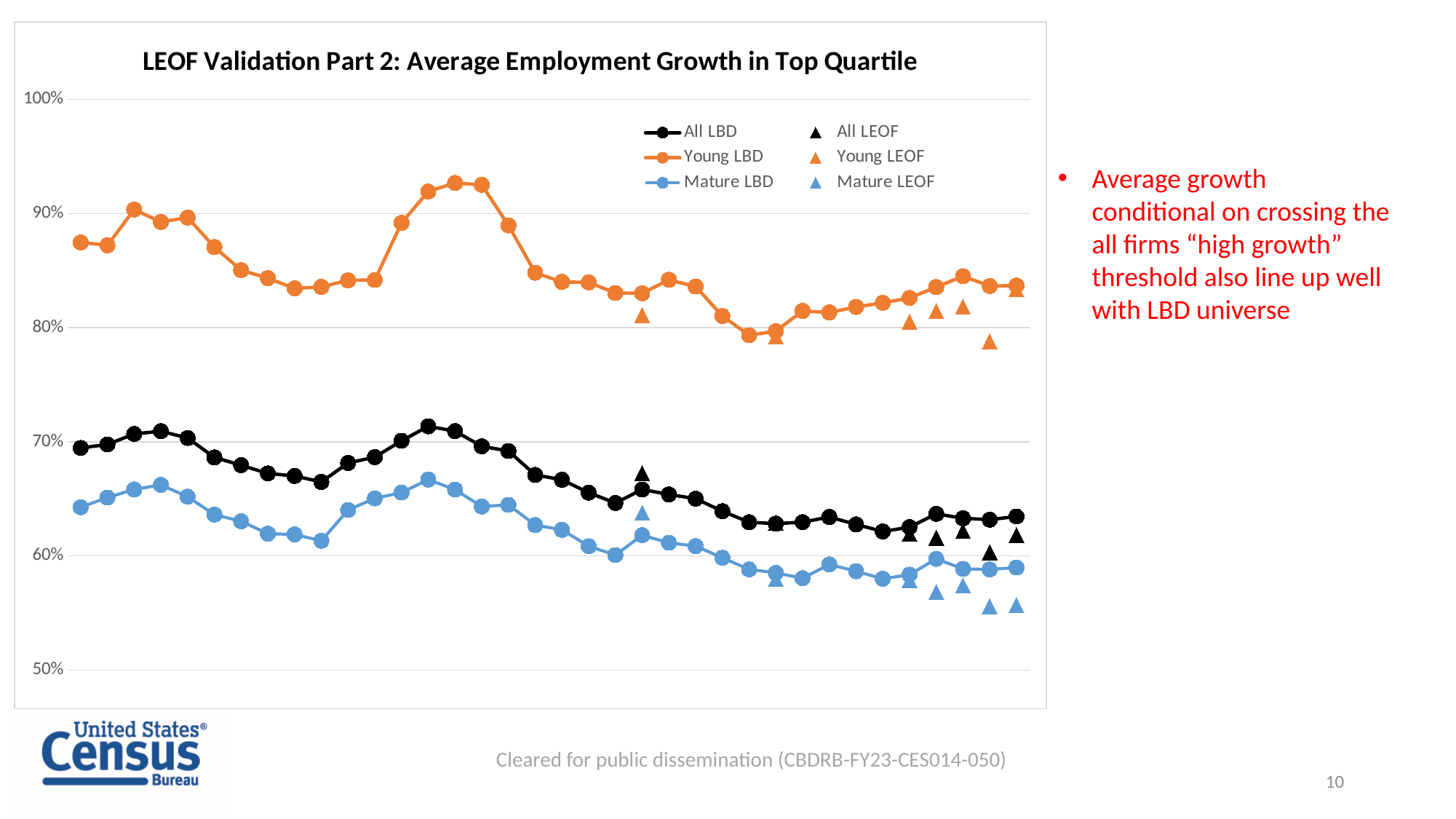
Which series in the chart has the highest values throughout? Young LBD Do the All LBD values overall rise or fall from the left end of the chart to the right end? fall What kind of chart is shown on the slide? line chart What is the title of the chart? LEOF Validation Part 2: Average Employment Growth in Top Quartile What is the lowest value shown on the chart's vertical axis? 50% Are the Mature LBD values greater or less than 70% across the whole chart? less Which of the three LBD line series has the lowest values throughout? Mature LBD What marker shape is used for the LEOF series in the chart? triangles Which series is plotted higher on the chart, All LBD or Mature LBD? All LBD How many series does the chart legend list? 6 Do the Mature LBD values overall rise or fall from the left end of the chart to the right end? fall Are the Young LBD values greater or less than 70% across the whole chart? greater